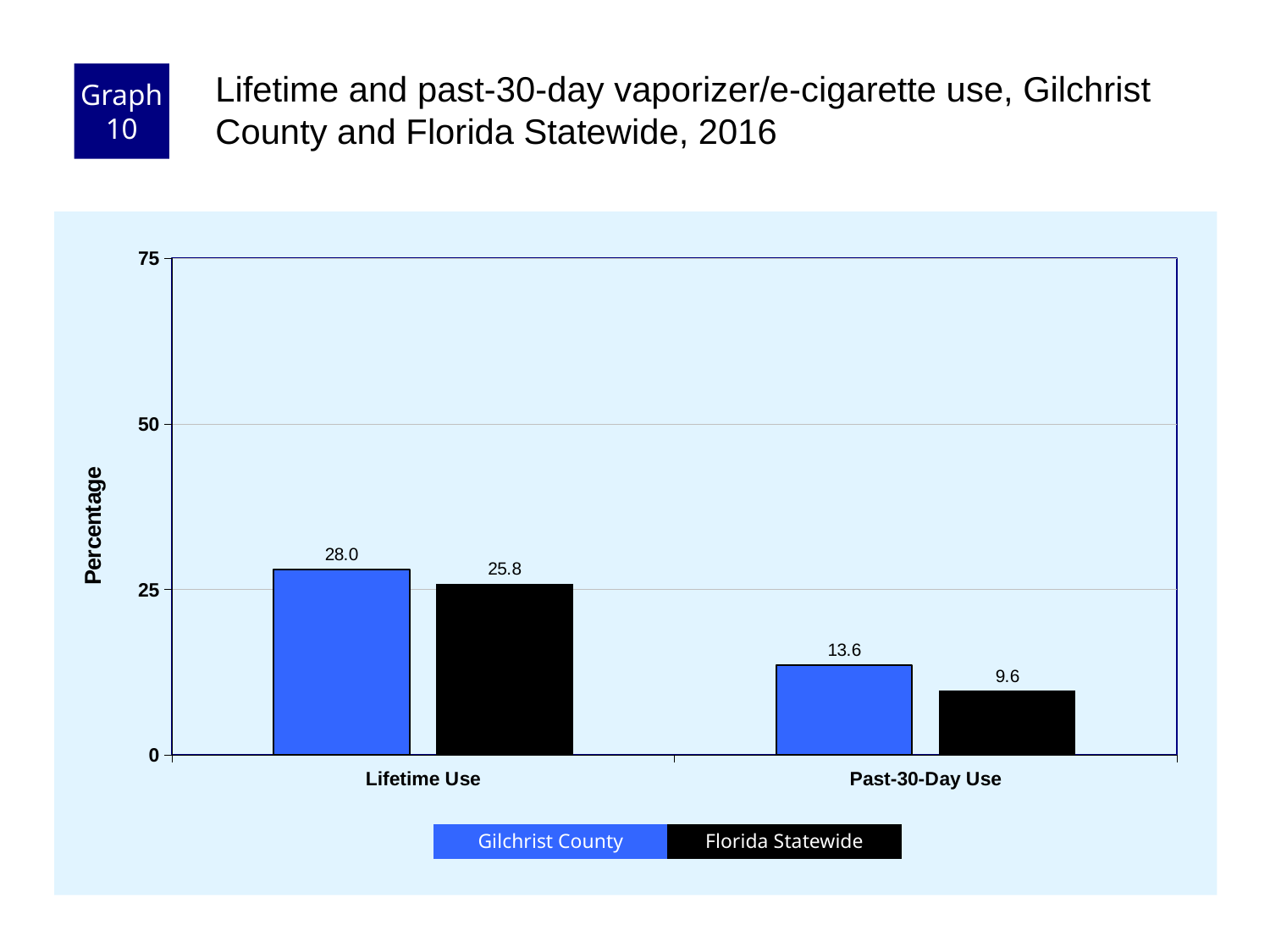
Is the Gilchrist County value for Lifetime Use greater or less than 25? greater What is the Gilchrist County value for Past-30-Day Use? 13.6 What is the Florida Statewide value for Past-30-Day Use? 9.6 How many series does the legend list? 2 For Lifetime Use, which is larger: Gilchrist County or Florida Statewide? Gilchrist County What kind of chart is shown on the slide? bar chart How many categories are shown on the x axis? 2 What is the Florida Statewide value for Lifetime Use? 25.8 Which category has the highest Gilchrist County value? Lifetime Use What is the Gilchrist County value for Lifetime Use? 28.0 What is the difference between the Gilchrist County and Florida Statewide values for Past-30-Day Use? 4.0 Which category has the lowest Florida Statewide value? Past-30-Day Use